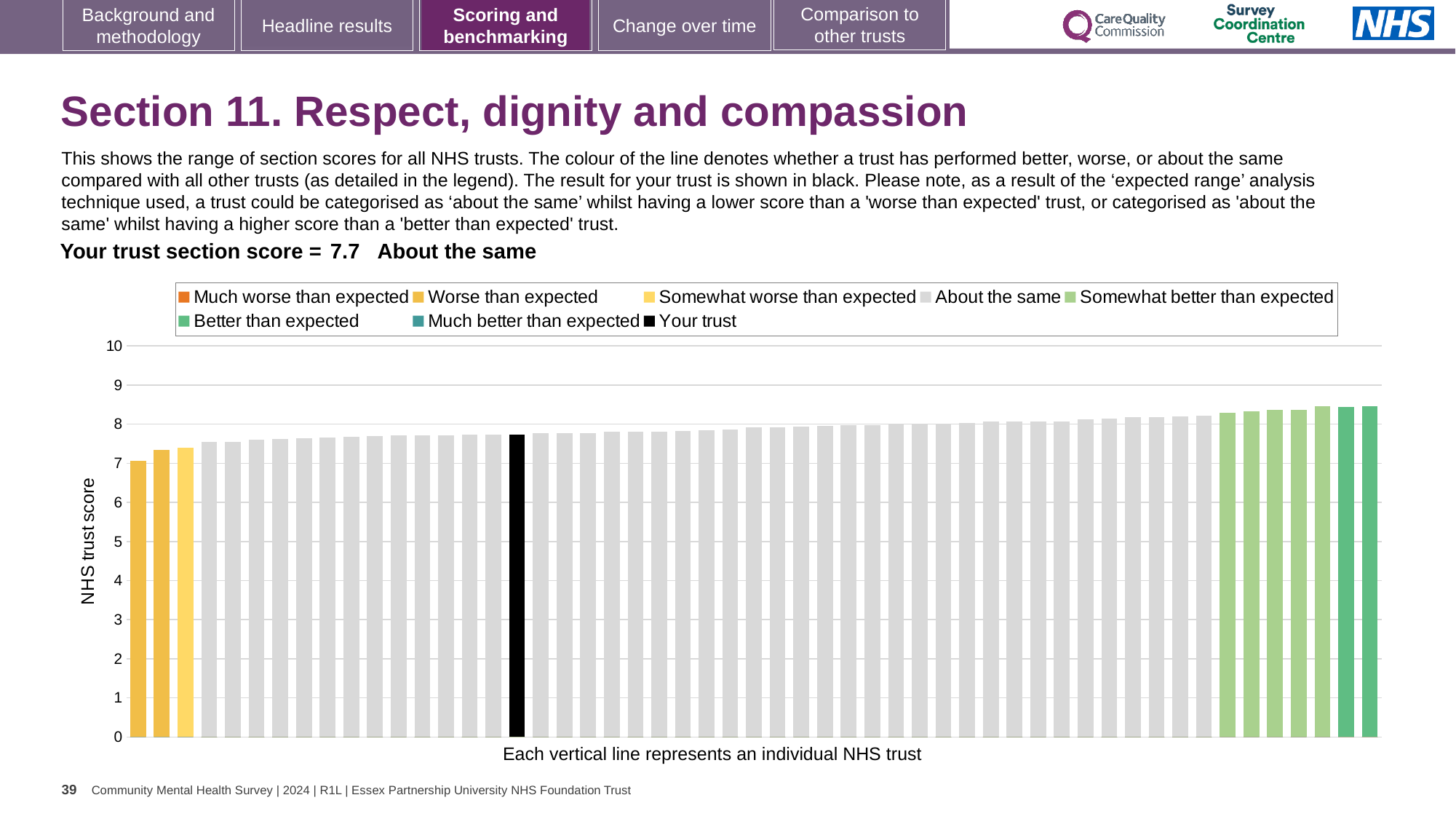
Do the bar values rise or fall from left to right along the x axis? rise Is the value of the lowest bar greater or less than 8? less Which is larger: the score for your trust or the score of the leftmost bar? your trust Is the value of the highest bar greater or less than 8? greater What colour is the bar representing your trust? black Which performance category is your trust placed in for this section? About the same How many entries does the chart legend list? 8 What is the label on the vertical axis of the chart? NHS trust score What is the section score for your trust? 7.7 What kind of chart is shown on the slide? bar chart Which is larger: the score for your trust or the score of the rightmost bar? the rightmost bar Is the value for your trust greater or less than 8? less